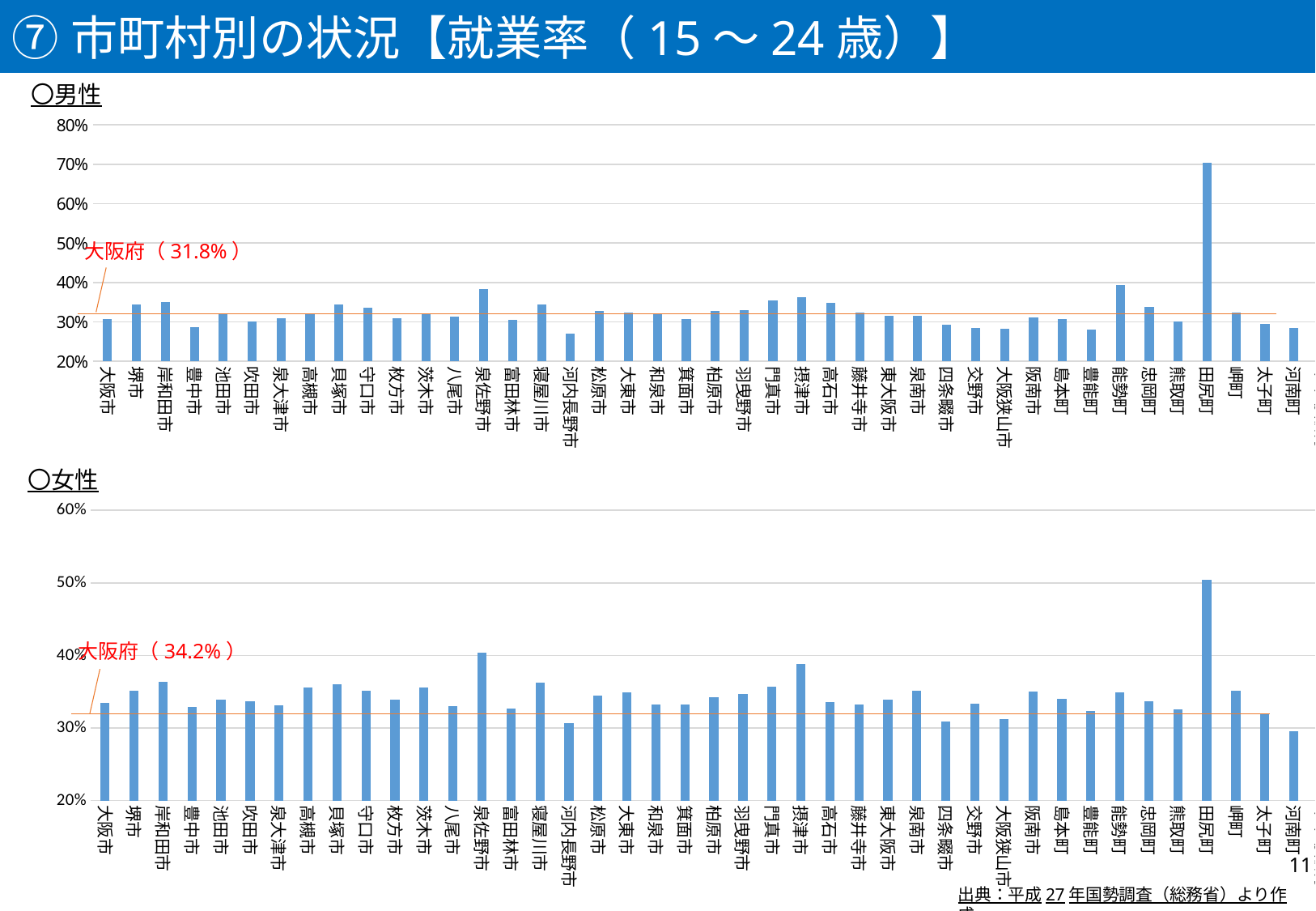
In the 男性 (male) chart, is the value for 田尻町 greater or less than 60%? greater In the 女性 (female) chart, is the value for 田尻町 greater or less than 40%? greater What is the difference between the 大阪府 female rate (女性 chart) and the 大阪府 male rate (男性 chart)? 2.4 percentage points In the 女性 (female) chart, which municipality has the highest employment rate? 田尻町 In the 女性 (female) chart, what is the employment rate shown for 大阪府? 34.2% What is the highest value shown on the vertical axis of the 男性 (male) chart? 80% In the 男性 (male) chart, is the value for 河内長野市 greater or less than 30%? less In the 男性 (male) chart, what is the employment rate shown for 大阪府? 31.8% In the 男性 (male) chart, which is larger, the value for 田尻町 or the value for 能勢町? 田尻町 In the 男性 (male) chart, which municipality has the highest employment rate? 田尻町 What kind of chart is used in the 男性 (male) chart? bar chart